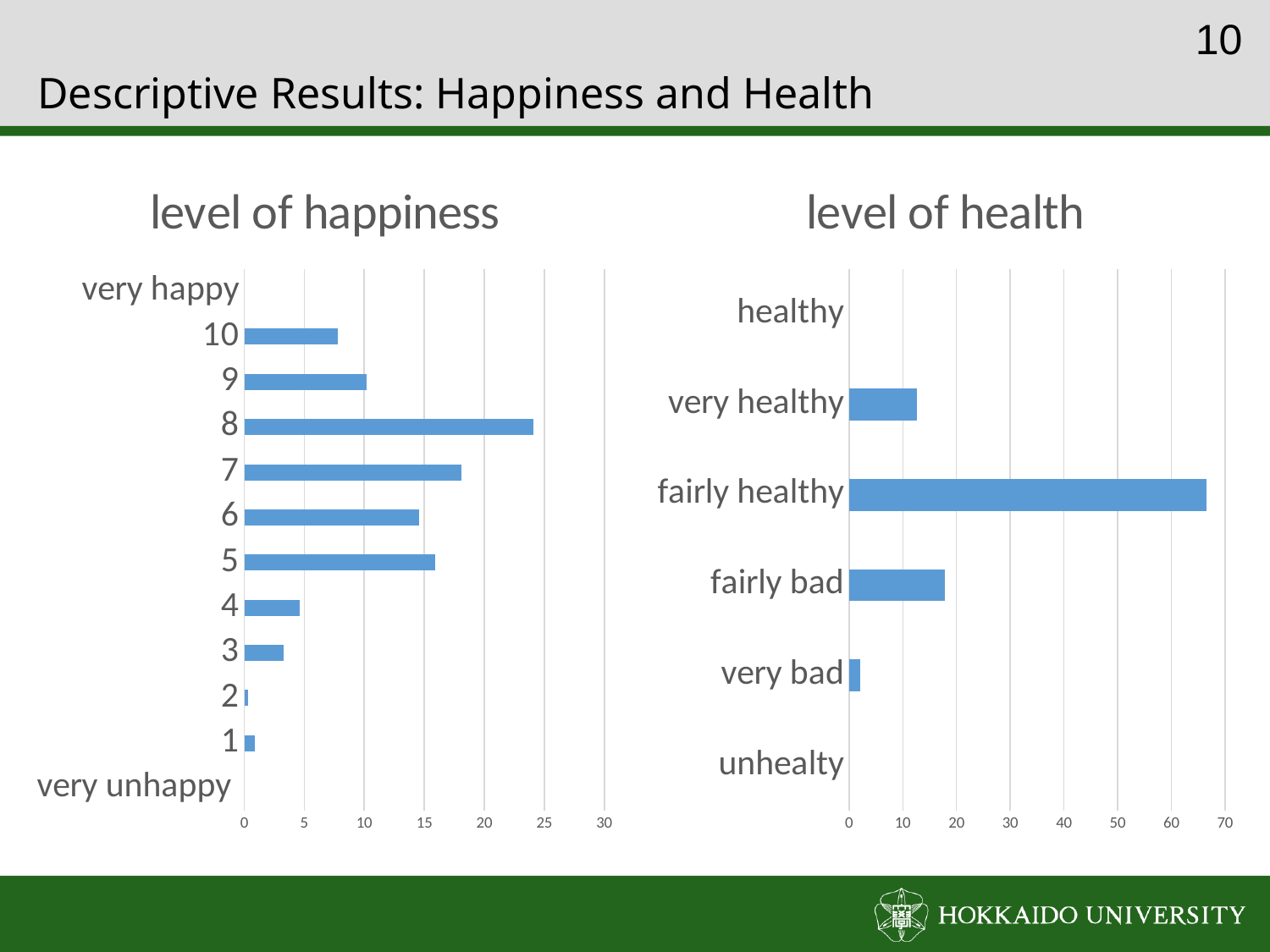
In the 'level of happiness' chart, how many categories are listed on the vertical axis? 12 In the 'level of health' chart, which category has the highest value? fairly healthy What is the title of the chart on the right side of the slide? level of health In the 'level of happiness' chart, is the value for 8 greater or less than 20? greater In the 'level of health' chart, is the value for fairly healthy greater or less than 60? greater In the 'level of happiness' chart, what kind of chart is shown? bar chart In the 'level of happiness' chart, which category has the highest value? 8 In the 'level of happiness' chart, which is larger, the value for 7 or the value for 6? 7 In the 'level of health' chart, which is larger, the value for fairly bad or the value for very healthy? fairly bad In the 'level of health' chart, how many categories are listed on the vertical axis? 6 In the 'level of happiness' chart, is the value for 10 greater or less than 10? less